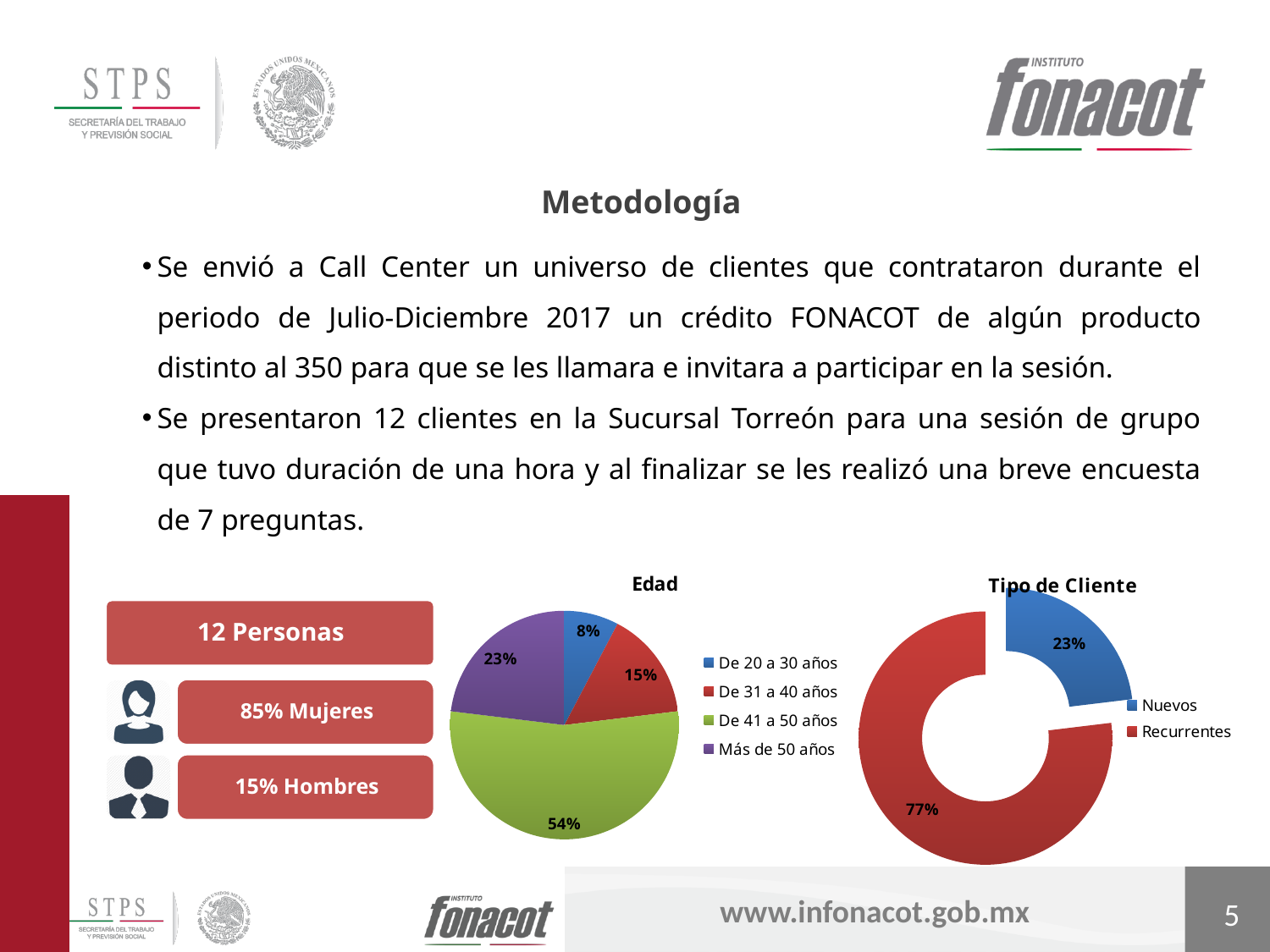
In the 'Tipo de Cliente' chart, what percentage of clients are 'Recurrentes'? 77% In the 'Tipo de Cliente' chart, what percentage of clients are 'Nuevos'? 23% What type of chart is the 'Edad' chart? Pie chart In the 'Edad' chart, which age group has the largest share? De 41 a 50 años In the 'Edad' chart, what percentage corresponds to 'De 20 a 30 años'? 8% In the 'Tipo de Cliente' chart, what colour represents 'Nuevos'? Blue In the 'Edad' chart, what percentage corresponds to 'De 41 a 50 años'? 54% In the 'Edad' chart, what percentage corresponds to 'Más de 50 años'? 23% In the 'Edad' chart, what is the difference between the shares of 'De 41 a 50 años' and 'De 31 a 40 años'? 39% In the 'Edad' chart, which age group has the smallest share? De 20 a 30 años In the 'Tipo de Cliente' chart, which category is larger, 'Nuevos' or 'Recurrentes'? Recurrentes In the 'Edad' chart, how many age groups are shown? 4